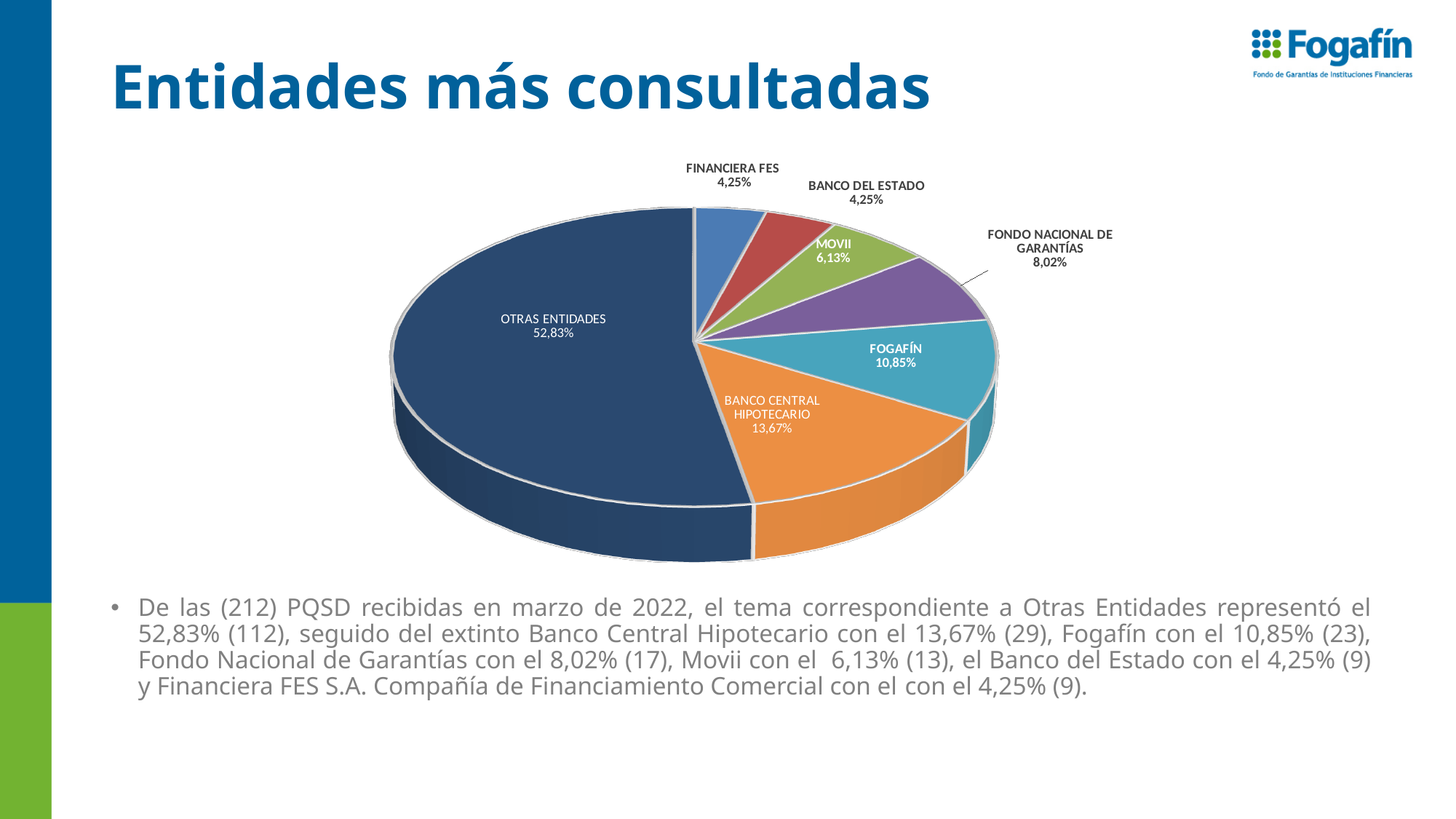
What is the value shown for FOGAFÍN? 10,85% What is the value shown for FONDO NACIONAL DE GARANTÍAS? 8,02% What is the title of the slide containing the chart? Entidades más consultadas What is the value shown for BANCO CENTRAL HIPOTECARIO? 13,67% Which is larger, the value for FONDO NACIONAL DE GARANTÍAS or the value for MOVII? FONDO NACIONAL DE GARANTÍAS What is the difference between the values for OTRAS ENTIDADES and BANCO CENTRAL HIPOTECARIO? 39,16% How many slices does the pie chart have? 7 What kind of chart is shown on the slide? Pie chart What share of the pie does OTRAS ENTIDADES represent? 52,83% What is the value shown for MOVII? 6,13% Which category has the largest slice of the pie? OTRAS ENTIDADES What is the difference between the values for BANCO CENTRAL HIPOTECARIO and FOGAFÍN? 2,82%